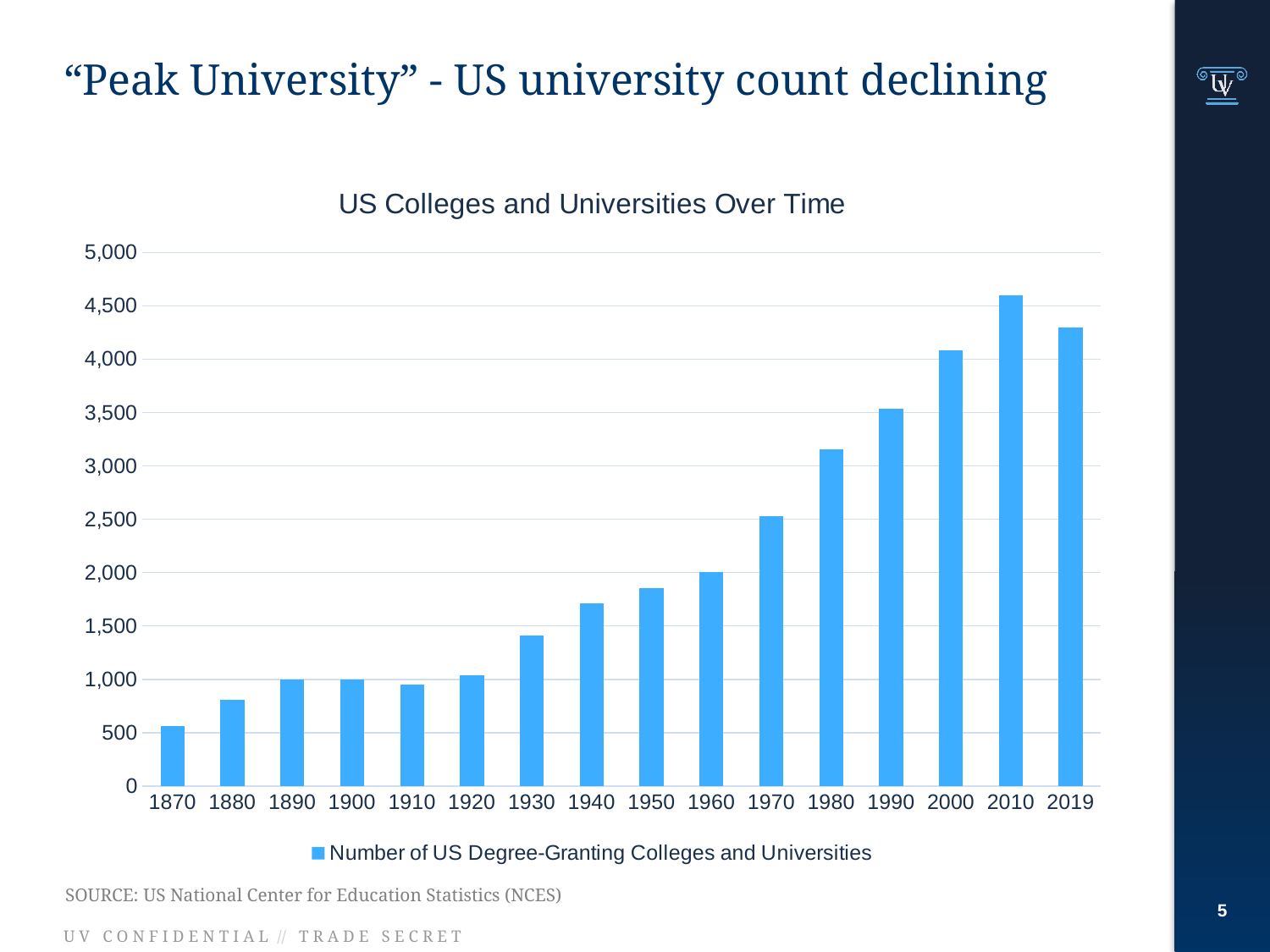
Does the number of colleges and universities rise or fall from 1870 to 2010? Rise What is the title of the chart? US Colleges and Universities Over Time How many series does the legend list? 1 Is the value for 1980 greater or less than 3,000? greater Is the value for 1880 greater or less than 1,000? less Which year has the highest number of US degree-granting colleges and universities? 2010 Is the value for 1940 greater or less than 1,500? greater Which year has the larger value, 2010 or 2019? 2010 What kind of chart is shown on the slide? Bar chart Which year has the lowest number of US degree-granting colleges and universities? 1870 How many years (bars) are plotted on the x axis? 16